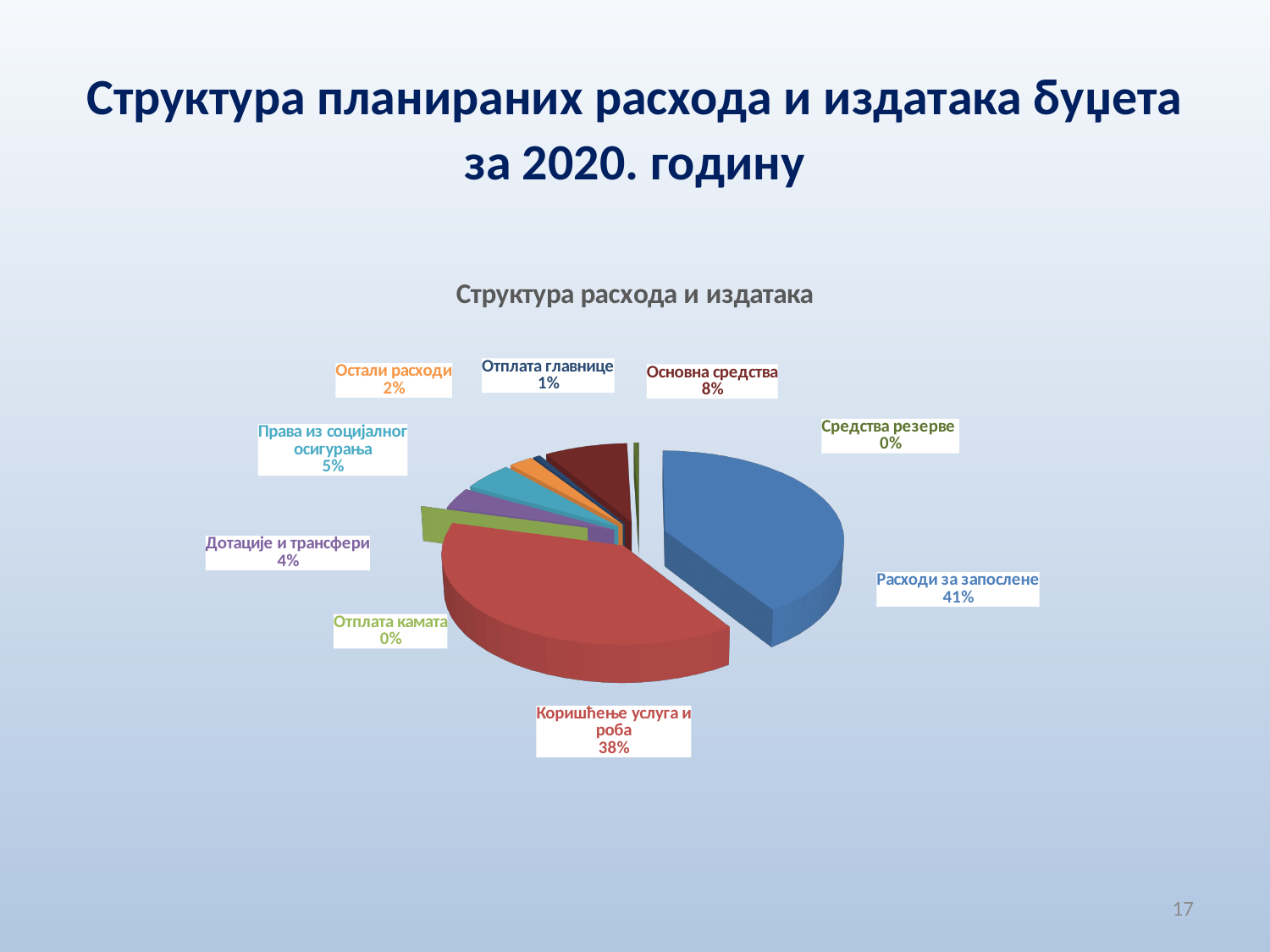
What share of the pie does Расходи за запослене represent? 41% Which category has the largest share of the pie? Расходи за запослене What share of the pie does Коришћење услуга и роба represent? 38% Which is larger, the share for Основна средства or the share for Права из социјалног осигурања? Основна средства What percentage is shown for Права из социјалног осигурања? 5% What percentage is shown for Отплата главнице? 1% What kind of chart is shown on the slide? Pie chart What percentage is shown for Основна средства? 8% How many categories are shown in the pie chart? 9 What is the title of the chart? Структура расхода и издатака What is the difference in percentage points between Расходи за запослене and Коришћење услуга и роба? 3 percentage points What percentage is shown for Дотације и трансфери? 4%